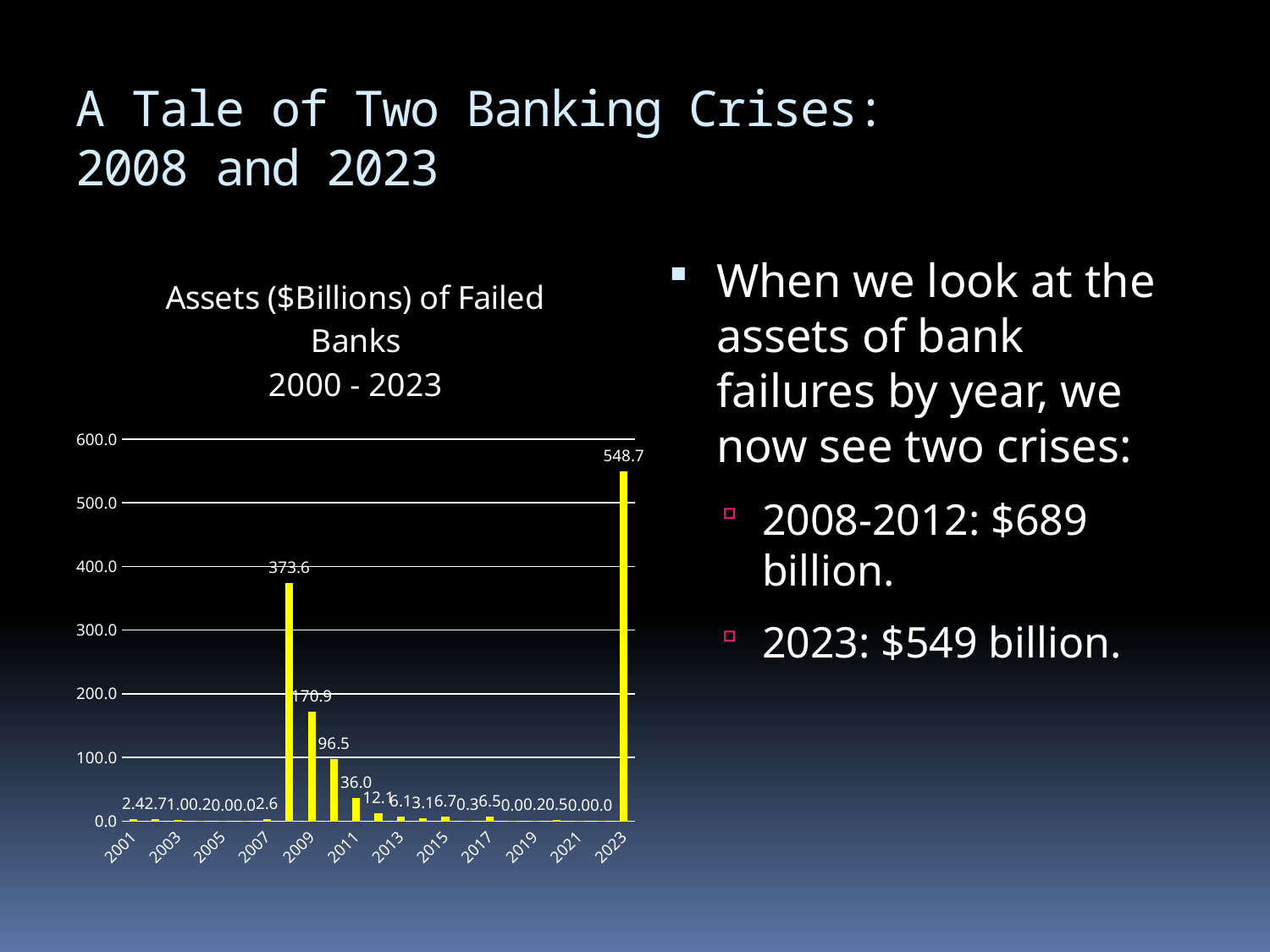
What colour are the bars in the chart? yellow Which year has the highest assets of failed banks? 2023 Is the second-tallest bar greater or less than 400? less What is the value of the bar for 2023? 548.7 How many year labels are shown on the x axis? 12 What type of chart is shown on the slide? bar chart What is the title of the chart? Assets ($Billions) of Failed Banks 2000 - 2023 What is the difference between the tallest bar (548.7) and the second-tallest bar (373.6)? 175.1 What is the value of the second-tallest bar in the chart? 373.6 Is the value for 2023 greater or less than 500? greater Which is larger, the bar for 2023 or the tallest bar of the 2008 crisis period? 2023 What is the value of the tallest bar in the chart? 548.7